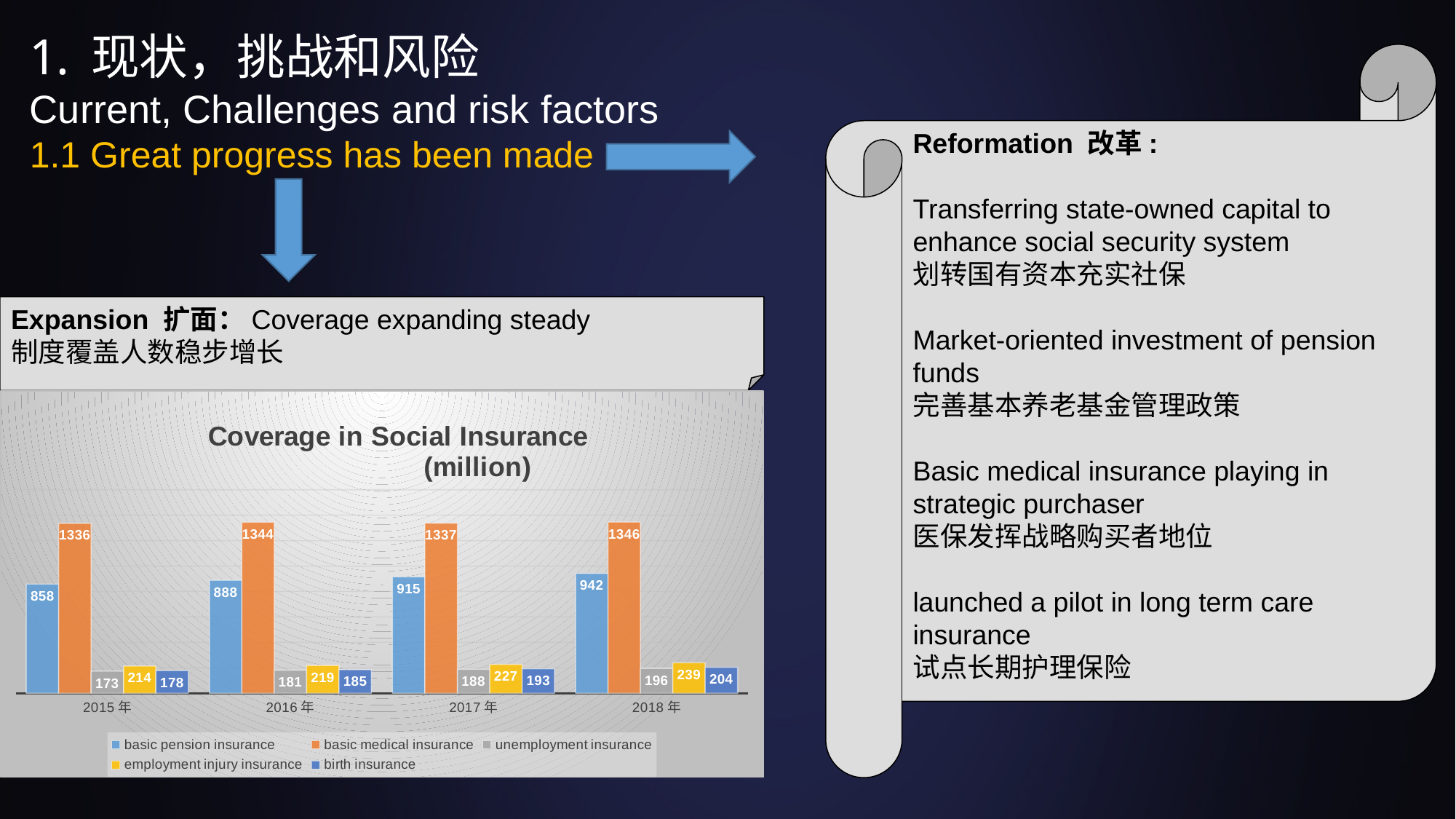
What is the value for basic medical insurance in 2018 年? 1346 What is the value for employment injury insurance in 2016 年? 219 What kind of chart is shown? bar chart What is the difference between basic pension insurance in 2018 年 and in 2015 年? 84 What is the value for basic pension insurance in 2015 年? 858 Does basic pension insurance rise or fall from 2015 年 to 2018 年? rise How many series does the legend list? 5 Which series has the lowest value in 2015 年? unemployment insurance Which series has the highest value in 2017 年? basic medical insurance What is the value for unemployment insurance in 2017 年? 188 What is the value for birth insurance in 2018 年? 204 Which is larger: employment injury insurance in 2017 年 or birth insurance in 2017 年? employment injury insurance